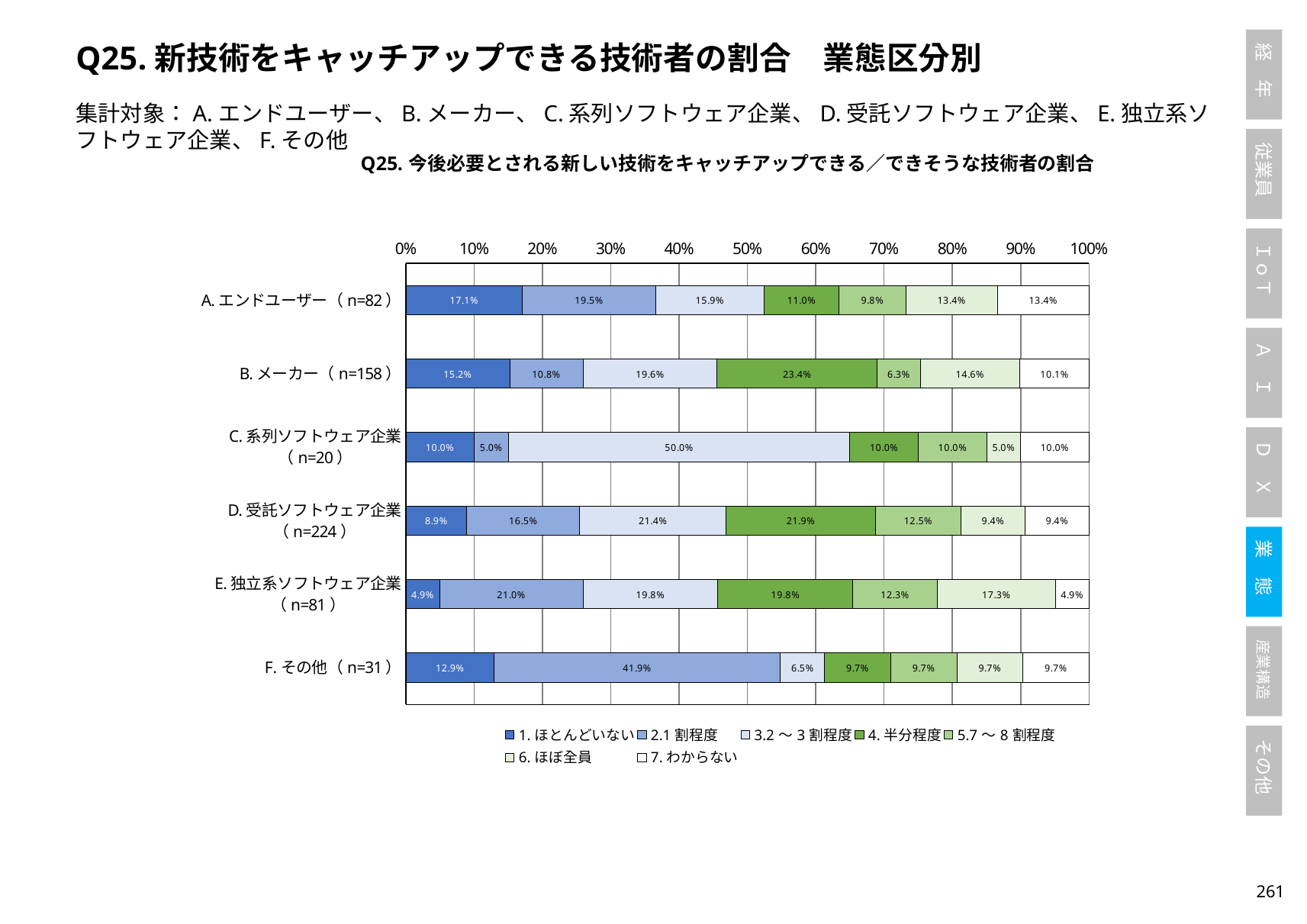
What is the value of "2. 1割程度" for F. その他 (n=31)? 41.9% What is the value of "3. 2～3割程度" for C. 系列ソフトウェア企業 (n=20)? 50.0% What type of chart is shown on the slide? Stacked horizontal bar chart What is the value of "1. ほとんどいない" for A. エンドユーザー (n=82)? 17.1% What is the difference between the "4. 半分程度" values for B. メーカー and A. エンドユーザー? 12.4% What is the sample size (n) shown for D. 受託ソフトウェア企業? 224 Which category has the lowest value for "1. ほとんどいない"? E. 独立系ソフトウェア企業 (n=81) How many series does the legend list? 7 Which is larger: the "6. ほぼ全員" value for E. 独立系ソフトウェア企業 or for D. 受託ソフトウェア企業? E. 独立系ソフトウェア企業 How many categories (業態) are plotted on the chart? 6 Which category has the highest value for "1. ほとんどいない"? A. エンドユーザー (n=82) What is the value of "4. 半分程度" for B. メーカー (n=158)? 23.4%